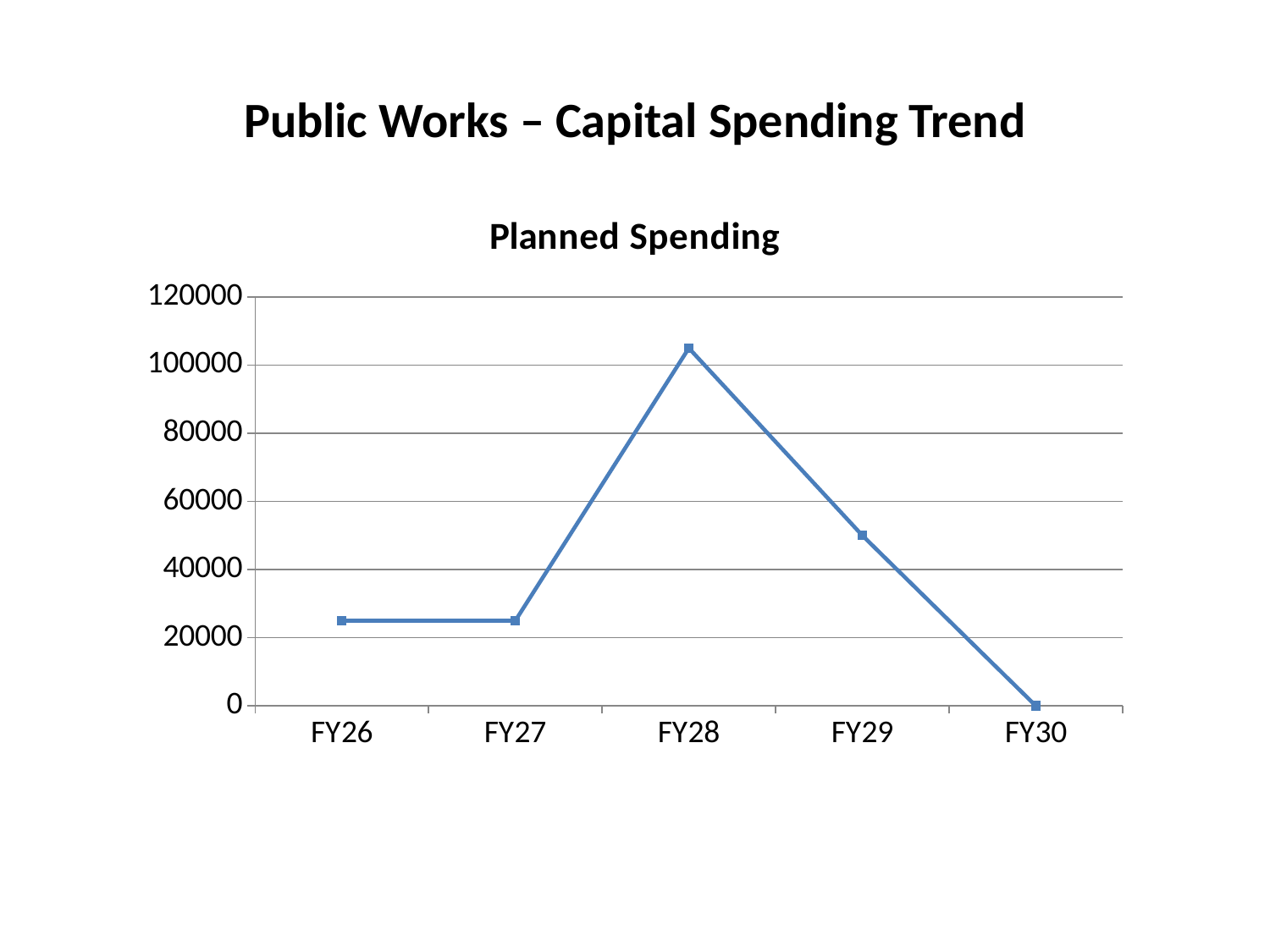
What is the title of the chart? Planned Spending From FY28 to FY30, do the values rise or fall? fall Which fiscal year has the highest planned spending? FY28 How many fiscal years are plotted on the x axis? 5 Is the value for FY29 greater or less than 60000? less Is the value for FY26 greater or less than 20000? greater Is the value for FY28 greater or less than 100000? greater Which is larger, the value for FY28 or the value for FY29? FY28 What is the planned spending value for FY30? 0 Which fiscal year has the lowest planned spending? FY30 What type of chart is shown on the slide? line chart